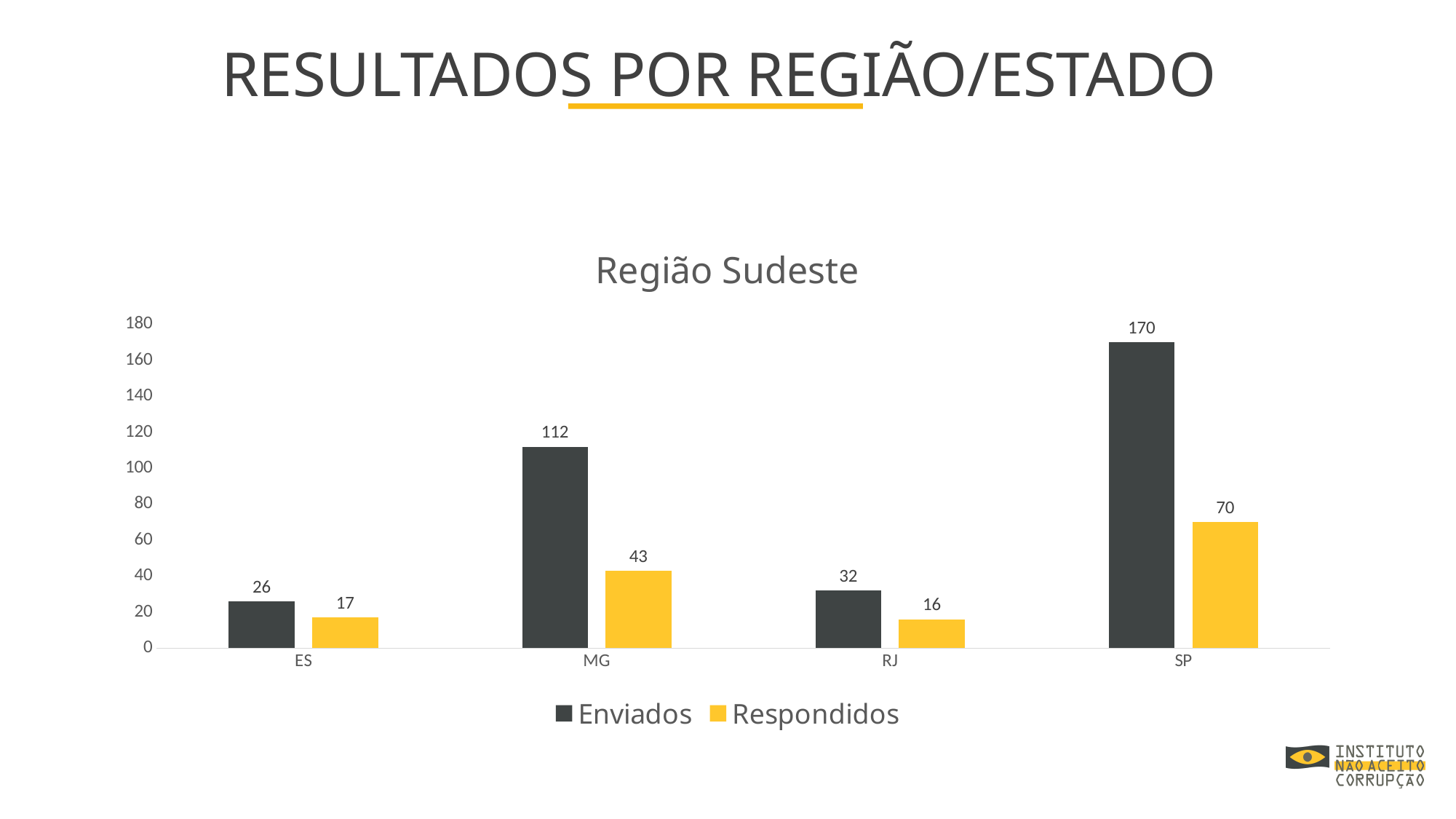
Is the Enviados value for MG greater or less than 100? greater Which state has the highest Enviados value? SP What is the difference between Enviados and Respondidos for SP? 100 What is the title of the chart? Região Sudeste Which state has the lowest Respondidos value? RJ How many series does the legend list? 2 How many states are shown on the x axis? 4 What is the Enviados value for MG? 112 What is the Respondidos value for RJ? 16 Which is larger, the Enviados value for ES or the Enviados value for RJ? RJ What kind of chart is shown? bar chart What is the Respondidos value for SP? 70